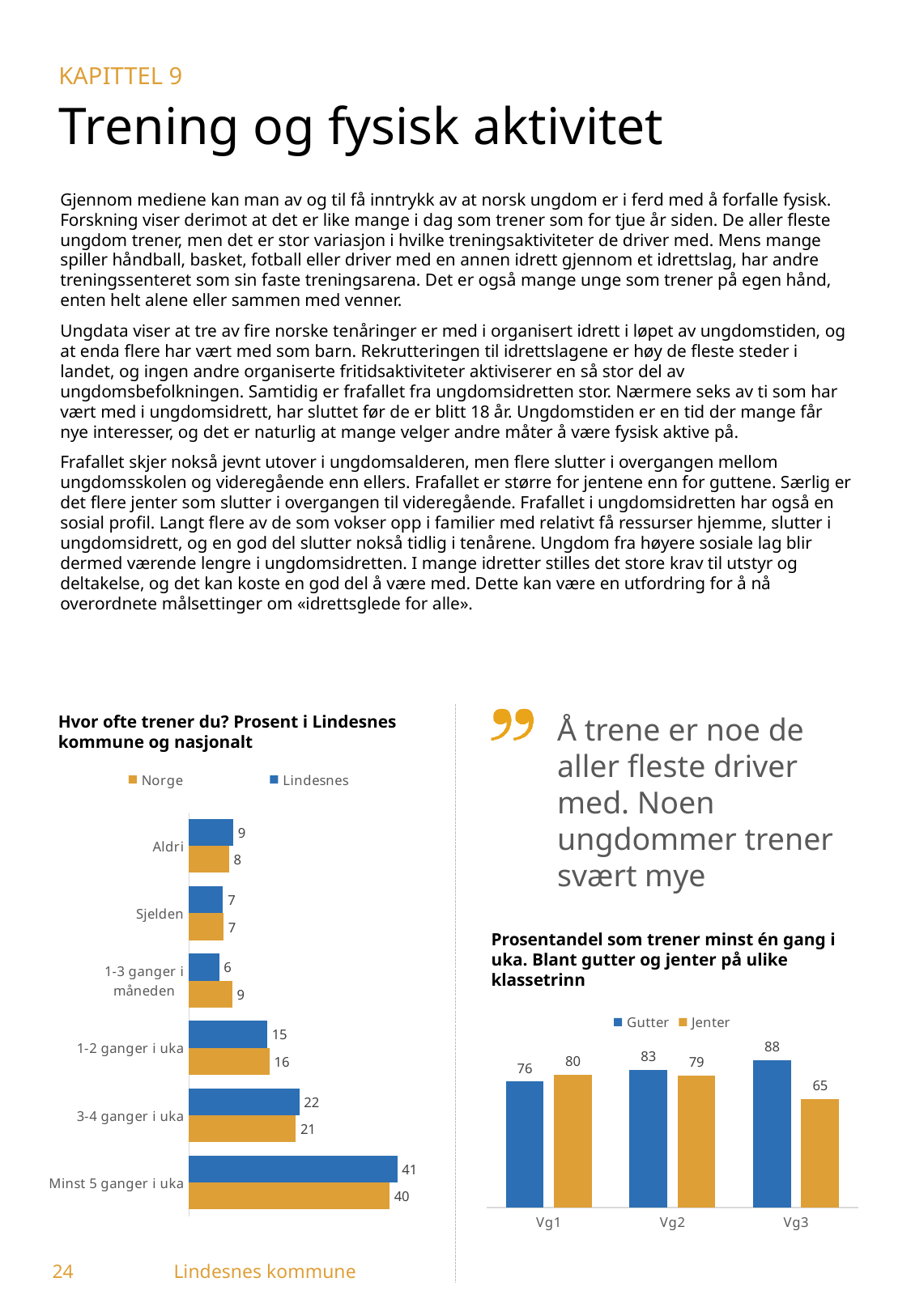
In the chart 'Prosentandel som trener minst én gang i uka', do the Gutter values rise or fall from Vg1 to Vg3? Rise In the chart 'Hvor ofte trener du? Prosent i Lindesnes kommune og nasjonalt', which category has the highest Lindesnes value? Minst 5 ganger i uka In the chart 'Prosentandel som trener minst én gang i uka', what is the difference between Gutter and Jenter for Vg3? 23 In the chart 'Prosentandel som trener minst én gang i uka', what is the Jenter value for Vg3? 65 In the chart 'Prosentandel som trener minst én gang i uka', which is larger for Vg1, Gutter or Jenter? Jenter In the chart 'Hvor ofte trener du? Prosent i Lindesnes kommune og nasjonalt', which category has the lowest Lindesnes value? 1-3 ganger i måneden What kind of chart is 'Hvor ofte trener du? Prosent i Lindesnes kommune og nasjonalt'? Bar chart In the chart 'Hvor ofte trener du? Prosent i Lindesnes kommune og nasjonalt', what is the Lindesnes value for 'Minst 5 ganger i uka'? 41 In the chart 'Hvor ofte trener du? Prosent i Lindesnes kommune og nasjonalt', what is the Norge value for '1-3 ganger i måneden'? 9 In the chart 'Hvor ofte trener du? Prosent i Lindesnes kommune og nasjonalt', what is the difference between the Lindesnes and Norge values for '1-3 ganger i måneden'? 3 In the chart 'Hvor ofte trener du? Prosent i Lindesnes kommune og nasjonalt', how many series does the legend list? 2 In the chart 'Hvor ofte trener du? Prosent i Lindesnes kommune og nasjonalt', how many categories are shown? 6